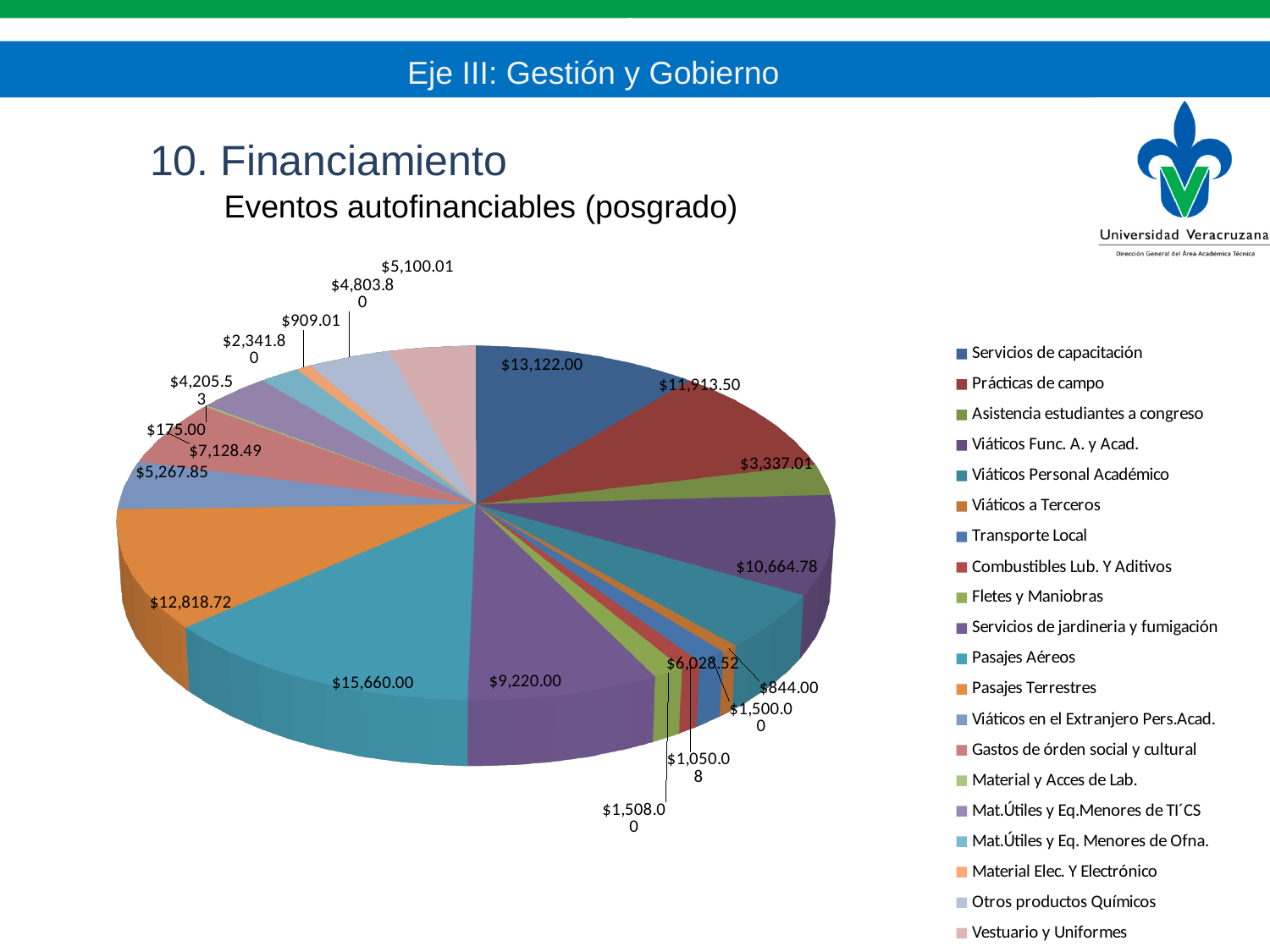
What is the value for Servicios de capacitación? $13,122.00 What kind of chart is shown on the slide? Pie chart What is the value for Viáticos Func. A. y Acad.? $10,664.78 What is the value for Pasajes Aéreos? $15,660.00 Which category has the smallest slice of the pie? Material y Acces de Lab. What is the value for Pasajes Terrestres? $12,818.72 Which is larger, Servicios de capacitación or Prácticas de campo? Servicios de capacitación What is the difference between the values for Pasajes Aéreos and Pasajes Terrestres? $2,841.28 How many categories does the legend of the pie chart list? 20 What is the subtitle of the chart shown under '10. Financiamiento'? Eventos autofinanciables (posgrado) What is the value for Material y Acces de Lab.? $175.00 Which category has the largest slice of the pie? Pasajes Aéreos